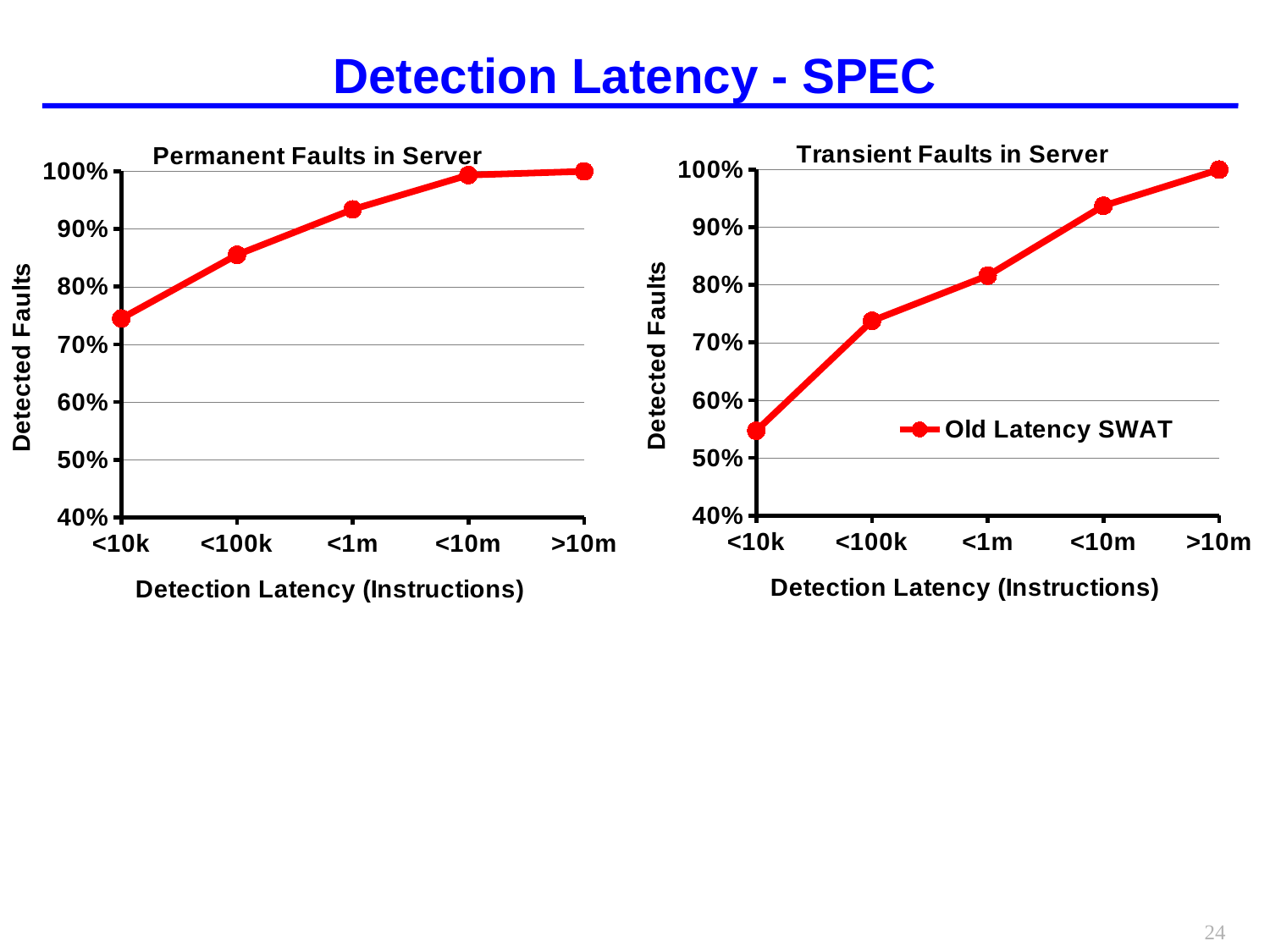
What type of chart is the "Permanent Faults in Server" chart? line chart In the "Permanent Faults in Server" chart, how many detection latency categories are shown on the x axis? 5 In the "Permanent Faults in Server" chart, is the value for <10k greater or less than 70%? greater In the "Transient Faults in Server" chart, is the value for <100k greater or less than 70%? greater In the "Transient Faults in Server" chart, how many series does the legend list? 1 In the "Permanent Faults in Server" chart, do the detected faults rise or fall as detection latency increases along the x axis? rise In the "Transient Faults in Server" chart, is the value for <10k greater or less than 60%? less In the "Transient Faults in Server" chart, which detection latency category has the lowest detected faults? <10k In the "Permanent Faults in Server" chart, which is larger, the value for <100k or the value for <1m? <1m What is the title of the chart on the right side of the slide? Transient Faults in Server In the "Transient Faults in Server" chart, what is the name of the series shown in the legend? Old Latency SWAT